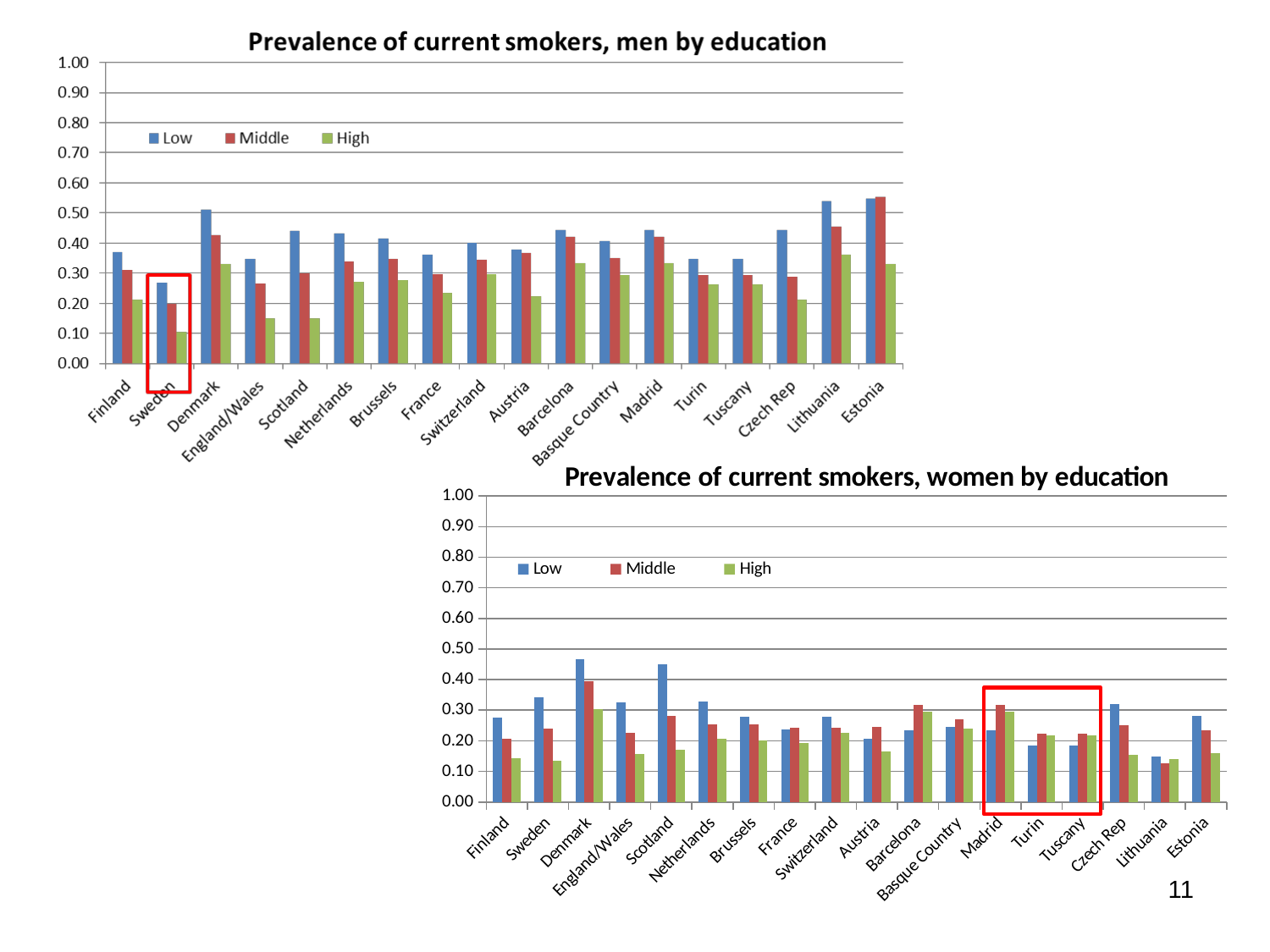
In the 'Prevalence of current smokers, women by education' chart, which categories are enclosed by the red box? Madrid, Turin, Tuscany How many series does the legend list in the 'Prevalence of current smokers, women by education' chart? 3 How many countries or regions are shown on the x axis of the 'Prevalence of current smokers, men by education' chart? 18 In the 'Prevalence of current smokers, women by education' chart, which category has the highest Middle value? Denmark In the 'Prevalence of current smokers, men by education' chart, is the Low value for Lithuania greater or less than 0.50? greater In the 'Prevalence of current smokers, men by education' chart, which category has the lowest High value? Sweden In the 'Prevalence of current smokers, men by education' chart, is the High value for Scotland greater or less than 0.20? less In the 'Prevalence of current smokers, women by education' chart, is the Low value for Scotland greater or less than 0.40? greater In the 'Prevalence of current smokers, men by education' chart, which is larger, the Low value for Denmark or the Low value for Sweden? Denmark In the 'Prevalence of current smokers, men by education' chart, which category has the highest Middle value? Estonia In the 'Prevalence of current smokers, women by education' chart, which category has the lowest Low value? Lithuania What kind of chart is the 'Prevalence of current smokers, men by education' chart? bar chart